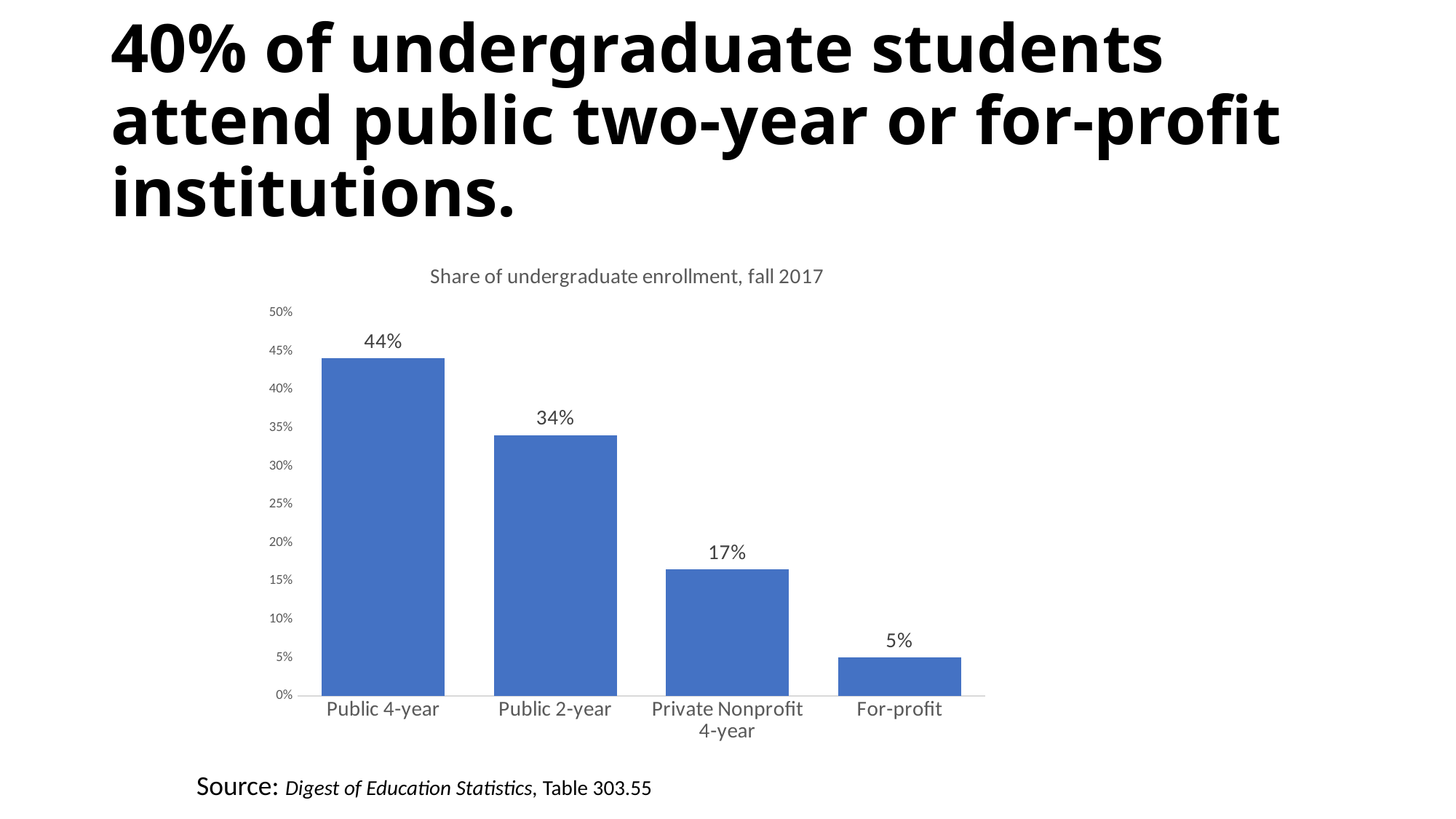
Which institution type has the lowest share of undergraduate enrollment? For-profit What is the share of undergraduate enrollment for For-profit institutions? 5% How many institution types are shown in the chart? 4 Which has a larger share of undergraduate enrollment, Public 2-year or Private Nonprofit 4-year? Public 2-year What is the share of undergraduate enrollment for Private Nonprofit 4-year institutions? 17% Which institution type has the highest share of undergraduate enrollment? Public 4-year What is the difference in enrollment share between Private Nonprofit 4-year and For-profit institutions? 12% What is the share of undergraduate enrollment for Public 2-year institutions? 34% What is the title of the chart? Share of undergraduate enrollment, fall 2017 What is the difference in enrollment share between Public 4-year and Public 2-year institutions? 10% What is the share of undergraduate enrollment for Public 4-year institutions? 44% What kind of chart is shown on the slide? Bar chart